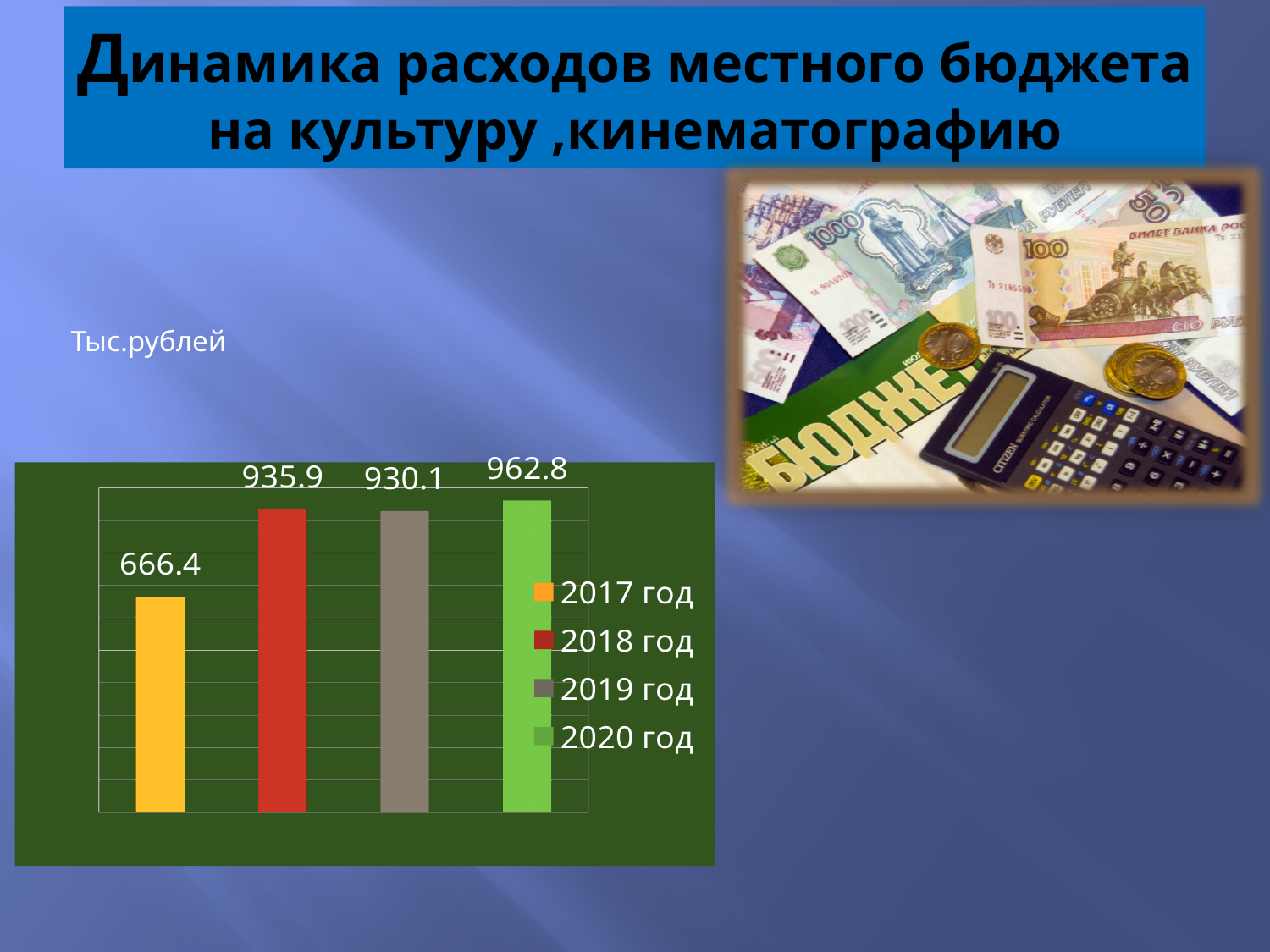
What is the difference between the values for 2020 год and 2017 год? 296.4 How many entries does the legend list? 4 Which is larger, the value for 2017 год or the value for 2019 год? 2019 год What kind of chart is shown on the slide? Bar chart What is the difference between the values for 2018 год and 2019 год? 5.8 Which year has the lowest value? 2017 год How many bars are plotted in the chart? 4 What is the value for 2019 год? 930.1 What is the value for 2017 год? 666.4 Which year has the highest value? 2020 год What is the value for 2018 год? 935.9 What is the value for 2020 год? 962.8